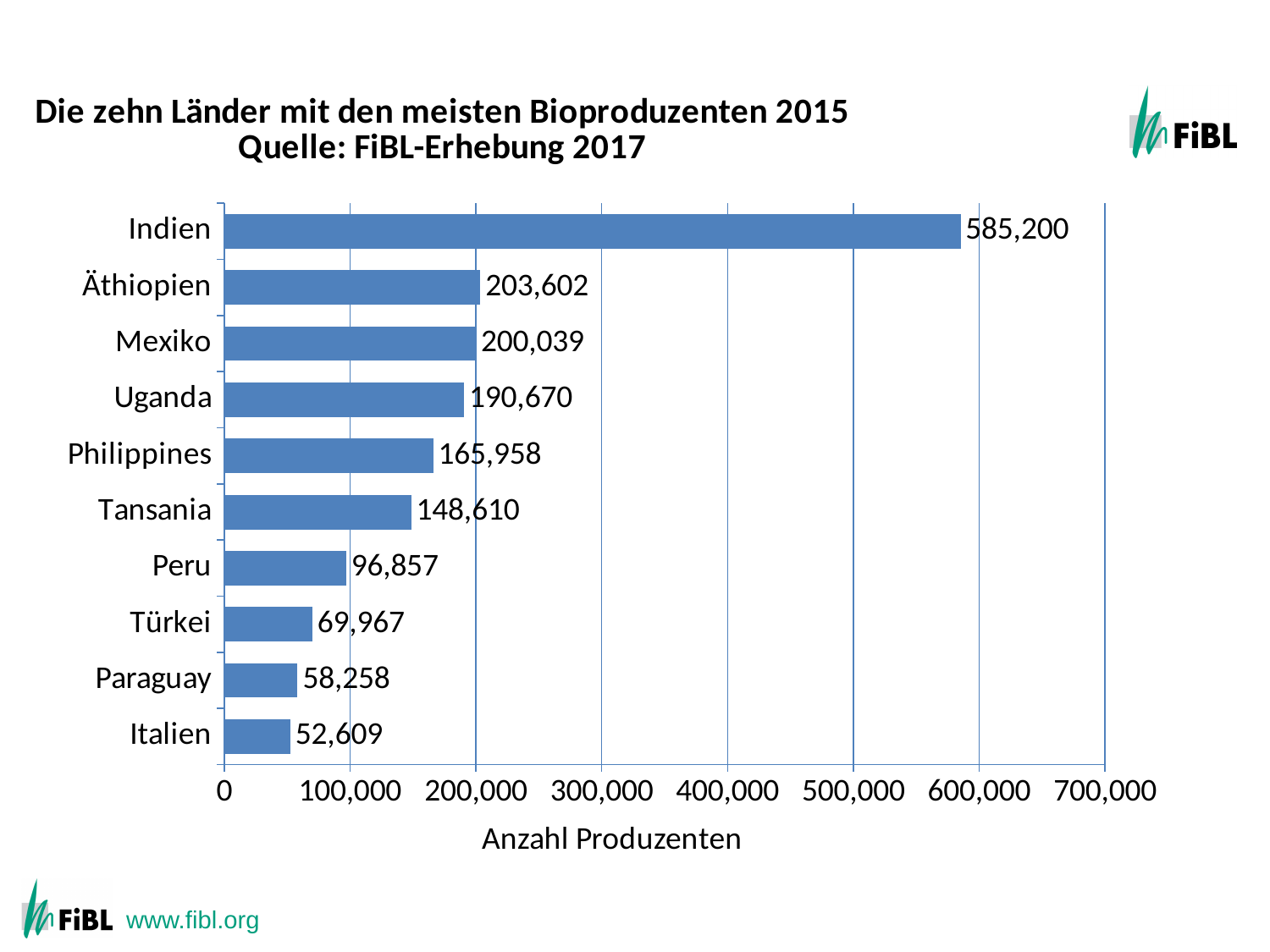
What is the difference in producers between Indien and Äthiopien? 381,598 What is the number of producers for Indien? 585,200 Which country has the lowest number of producers? Italien What is the label of the horizontal axis? Anzahl Produzenten Is the value for Mexiko greater or less than 300,000? less How many countries are shown in the chart? 10 What is the number of producers for Paraguay? 58,258 What is the number of producers for Philippines? 165,958 What is the difference in producers between Peru and Türkei? 26,890 Which has more producers, Uganda or Tansania? Uganda Which country has the highest number of producers? Indien What type of chart is shown on the slide? bar chart